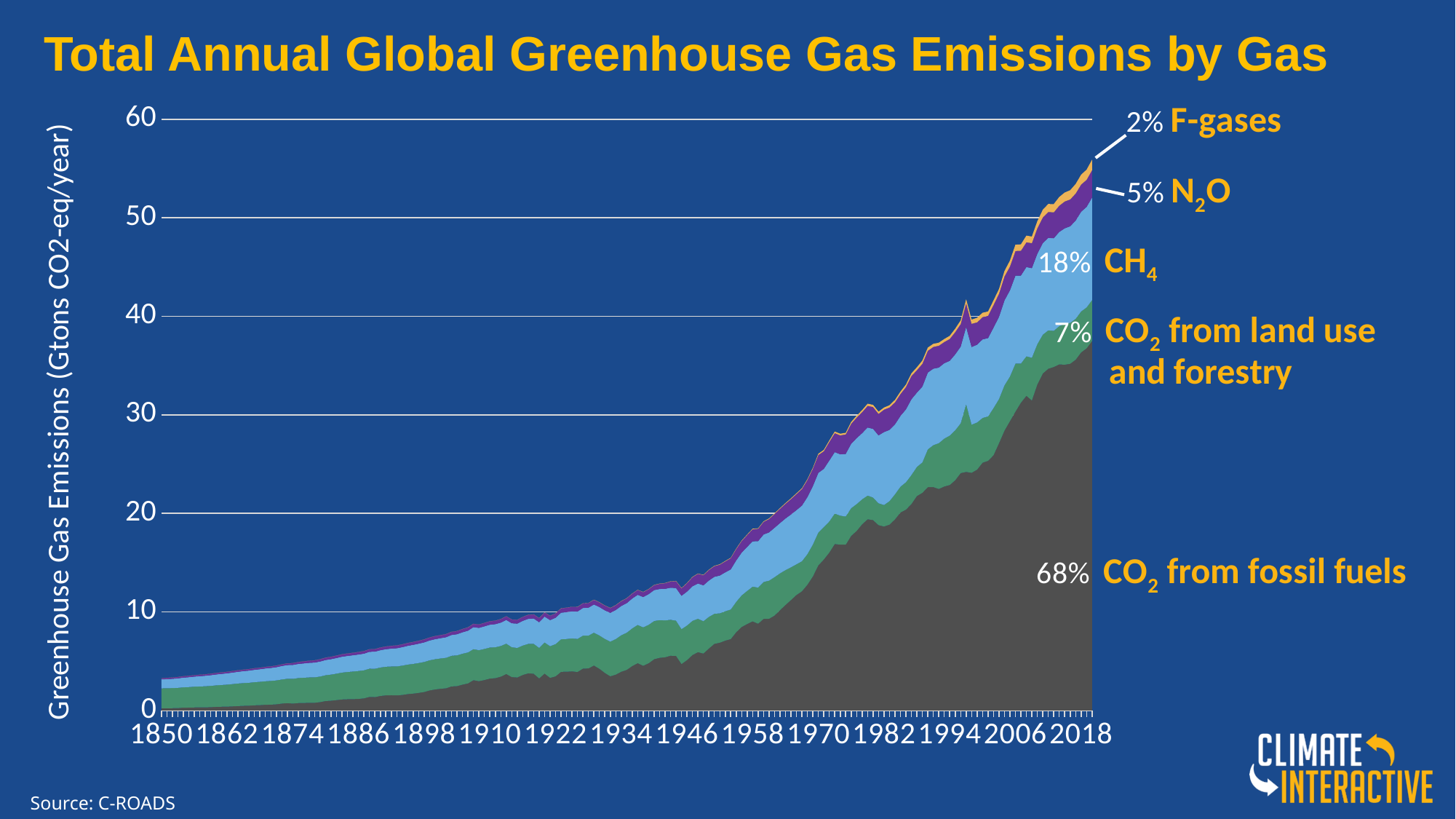
Is the total greenhouse gas emissions value in 2018 greater or less than 50 Gtons CO2-eq/year? greater Which gas category has the largest share of emissions? CO2 from fossil fuels What share of total emissions is N2O? 5% Do total greenhouse gas emissions rise or fall from 1850 to 2018? Rise How many percentage points larger is the share of CO2 from fossil fuels than the share of CH4? 50% Which has a larger share of emissions, N2O or CO2 from land use and forestry? CO2 from land use and forestry How many gas categories are shown in the chart? 5 What share of total emissions comes from CO2 from fossil fuels? 68% What kind of chart is shown on the slide? Stacked area chart Which gas category has the smallest share of emissions? F-gases What share of total emissions is CH4? 18% What share of total emissions comes from CO2 from land use and forestry? 7%